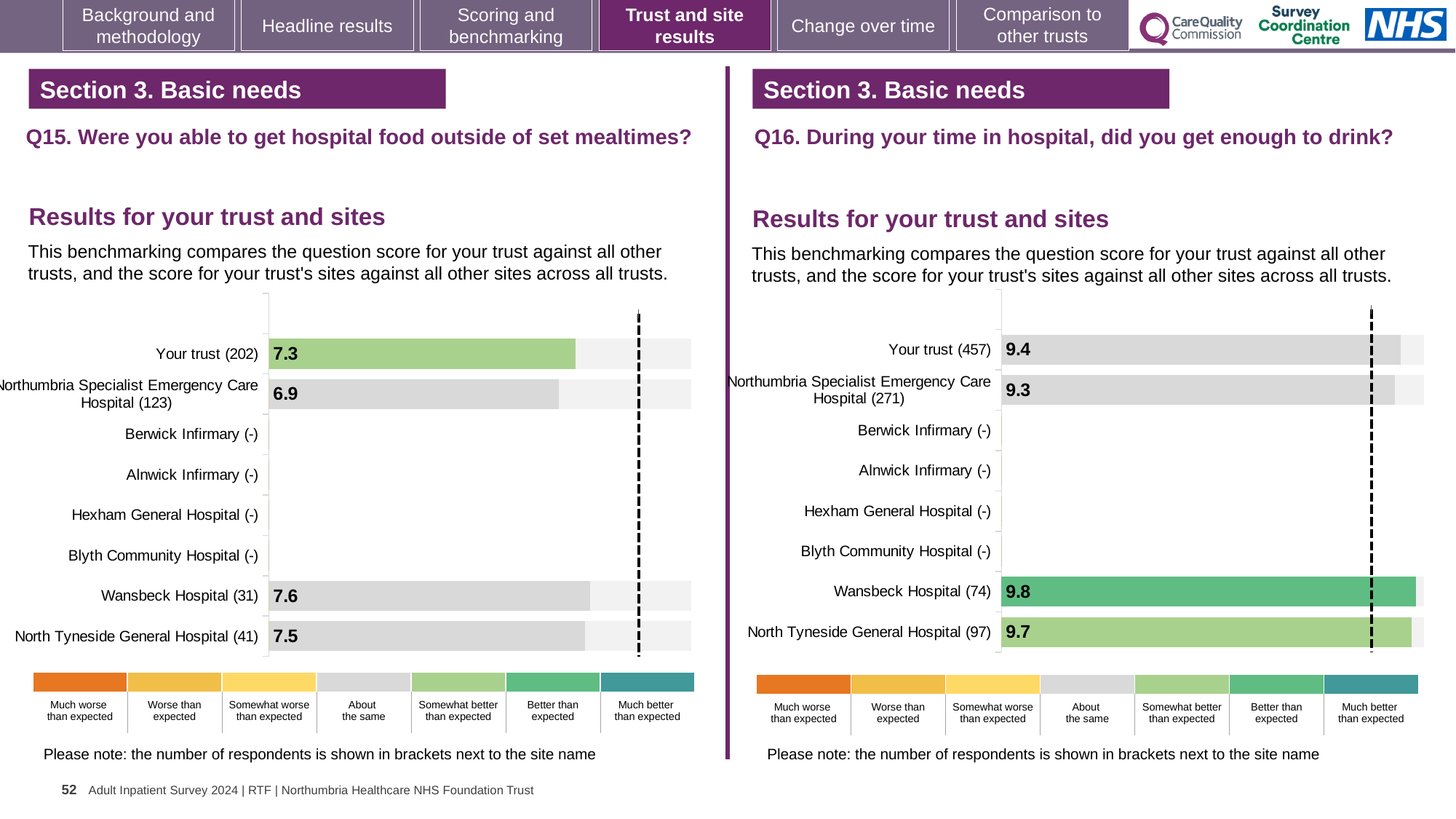
In the Q16 chart, how many respondents are shown in brackets for Your trust? 457 In the Q15 chart, what is the score for Northumbria Specialist Emergency Care Hospital? 6.9 In the Q16 chart, which is larger: the score for Wansbeck Hospital or the score for Your trust? Wansbeck Hospital In the Q15 chart, what is the difference between the scores for Wansbeck Hospital and Northumbria Specialist Emergency Care Hospital? 0.7 What kind of chart is used on the Q15 side of the slide? Bar chart In the Q15 chart, which site or trust row has the highest score? Wansbeck Hospital In the Q15 chart, which site or trust row has the lowest score? Northumbria Specialist Emergency Care Hospital In the Q16 chart, what is the difference between the scores for Wansbeck Hospital and Northumbria Specialist Emergency Care Hospital? 0.5 In the Q16 chart, what is the score for North Tyneside General Hospital? 9.7 In the Q16 chart (did you get enough to drink), what is the score for Your trust? 9.4 In the Q16 chart, which site or trust row has the highest score? Wansbeck Hospital In the Q15 chart (hospital food outside of set mealtimes), what is the score for Your trust? 7.3